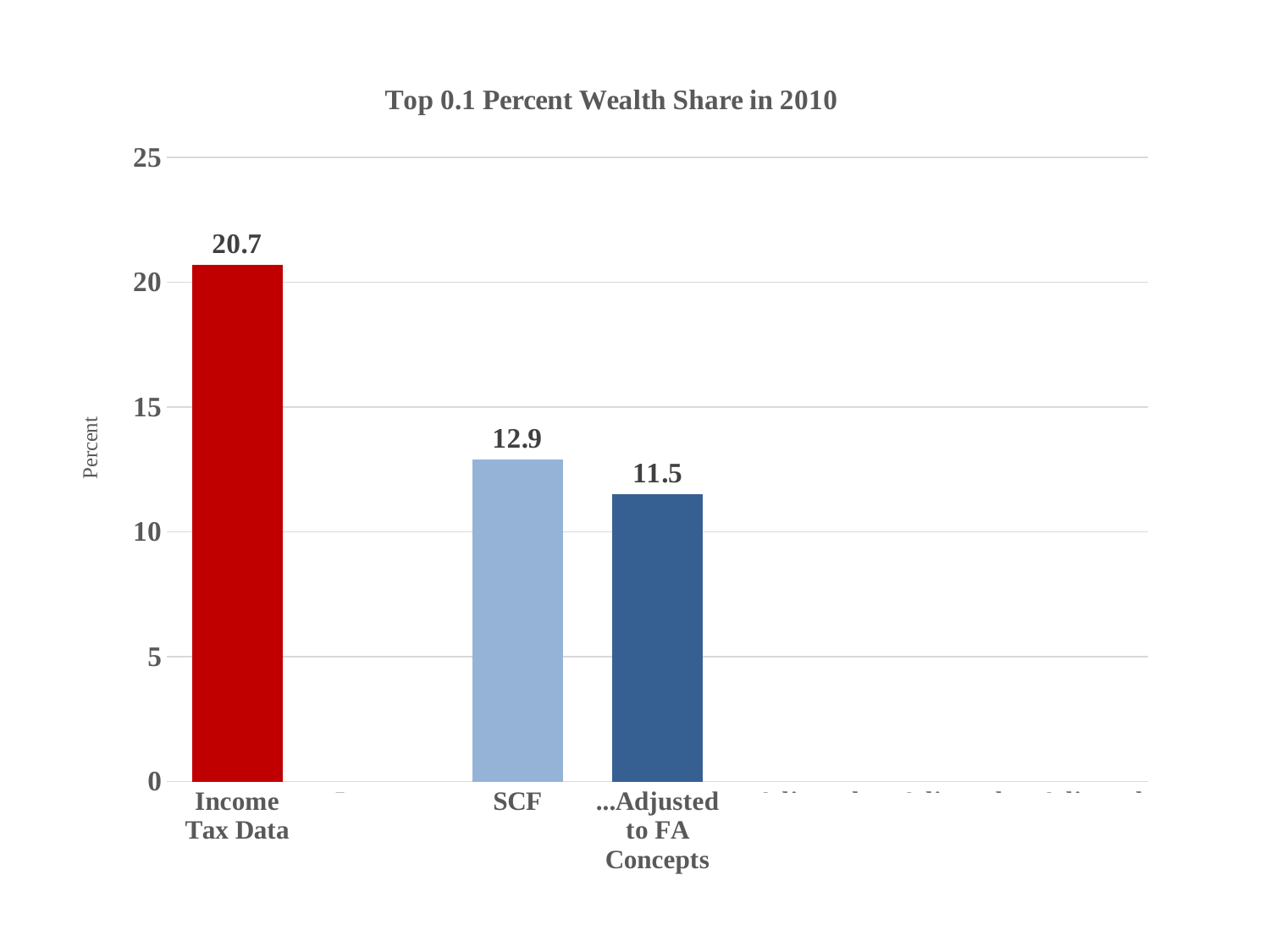
Is the value for Income Tax Data greater or less than 20? greater How many labelled bars are plotted on the chart? 3 What is the difference between the Income Tax Data value and the SCF value? 7.8 Which category has the highest value? Income Tax Data What is the value for Income Tax Data? 20.7 What kind of chart is shown on the slide? bar chart Which category has the lowest value? ...Adjusted to FA Concepts What is the value for ...Adjusted to FA Concepts? 11.5 Which is larger, the value for SCF or the value for ...Adjusted to FA Concepts? SCF What is the difference between the SCF value and the ...Adjusted to FA Concepts value? 1.4 What is the title of the chart? Top 0.1 Percent Wealth Share in 2010 What is the value for SCF? 12.9